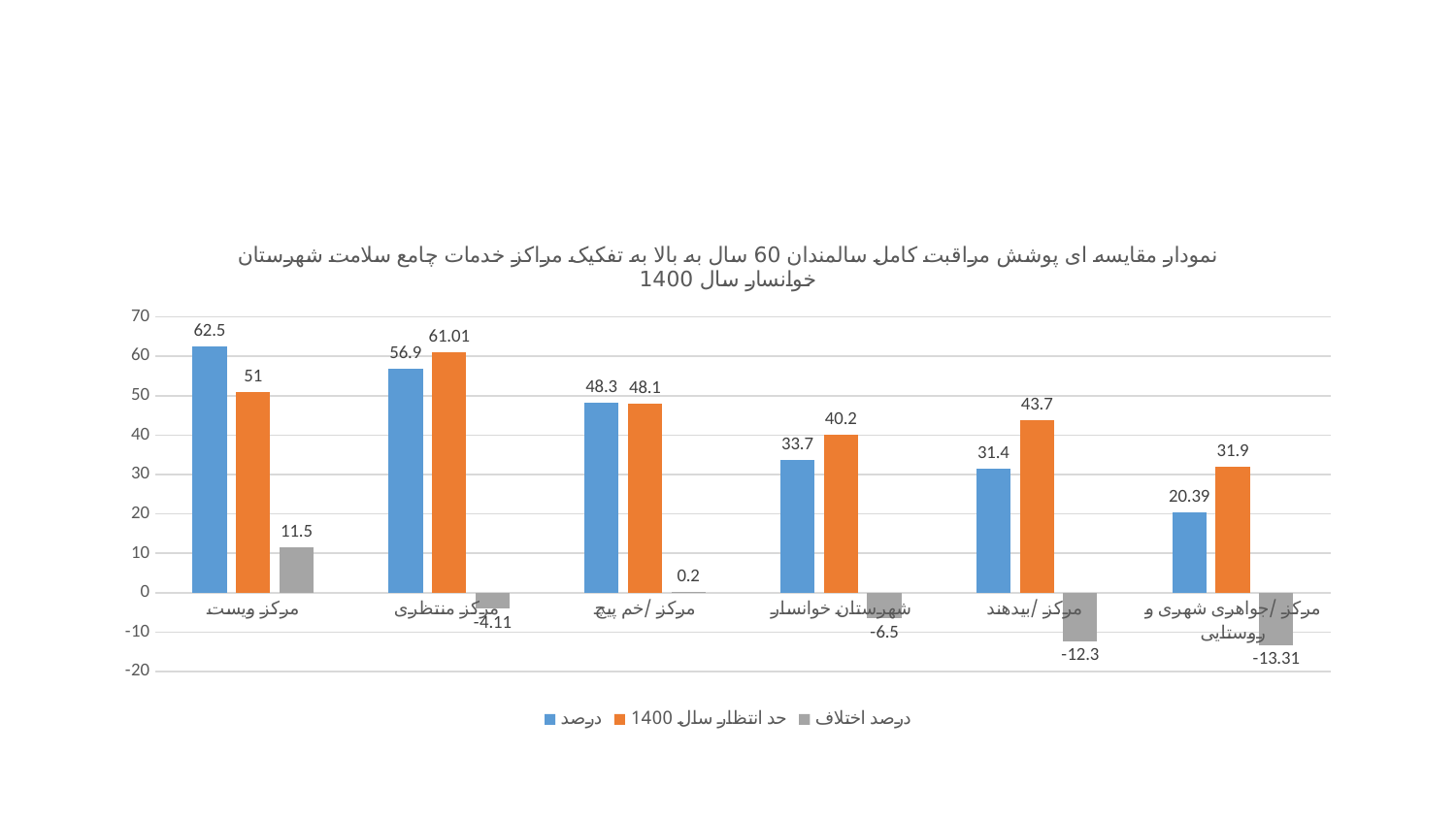
Which category has the highest value in the درصد series? مرکز ویست What is the value of the درصد series for مرکز ویست? 62.5 Which is larger for مرکز /بیدهند: the درصد value or the حد انتظار سال 1400 value? حد انتظار سال 1400 Which colour represents the حد انتظار سال 1400 series? orange What kind of chart is shown on the slide? bar chart What is the difference between the درصد value and the حد انتظار سال 1400 value for شهرستان خوانسار? 6.5 Is the درصد value for مرکز /جواهری شهری و روستایی greater or less than 30? less What is the value of the حد انتظار سال 1400 series for مرکز منتظری? 61.01 Which category has the lowest value in the درصد اختلاف series? مرکز /جواهری شهری و روستایی What is the value of the درصد اختلاف series for مرکز /بیدهند? -12.3 How many series does the legend list? 3 How many categories are shown on the x axis? 6